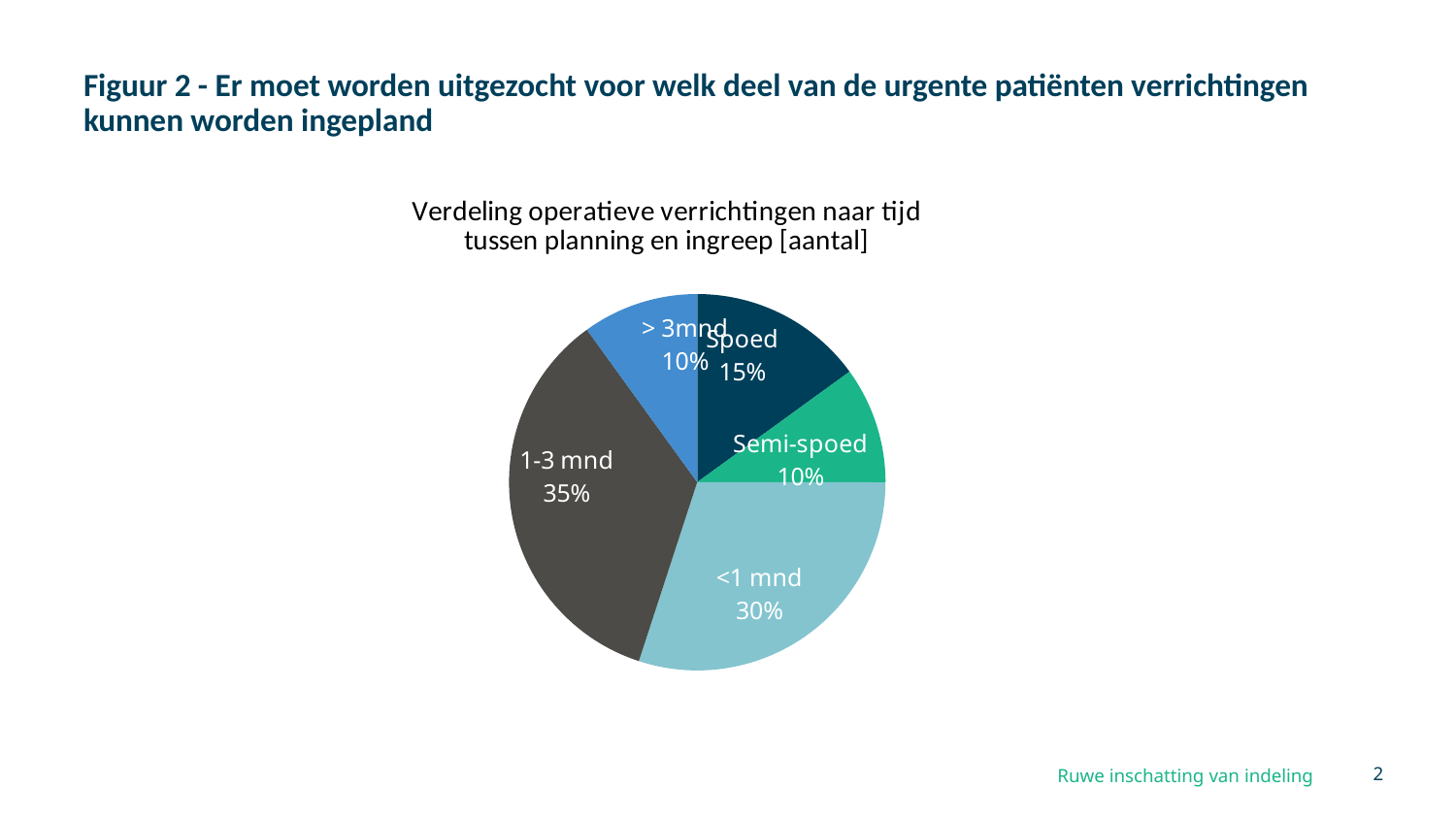
What share of the pie does the '1-3 mnd' slice represent? 35% What kind of chart is shown on the slide? Pie chart How many slices does the pie chart have? 5 What share of the pie does the '<1 mnd' slice represent? 30% What is the combined share of the 'Spoed' and 'Semi-spoed' slices? 25% What is the difference in percentage points between the '1-3 mnd' slice and the '<1 mnd' slice? 5% What share of the pie does the 'Spoed' slice represent? 15% Which two categories share the same percentage of the pie? Semi-spoed and > 3mnd What is the title of the pie chart? Verdeling operatieve verrichtingen naar tijd tussen planning en ingreep [aantal] Which slice is larger, 'Spoed' or 'Semi-spoed'? Spoed Which category has the largest share of the pie? 1-3 mnd